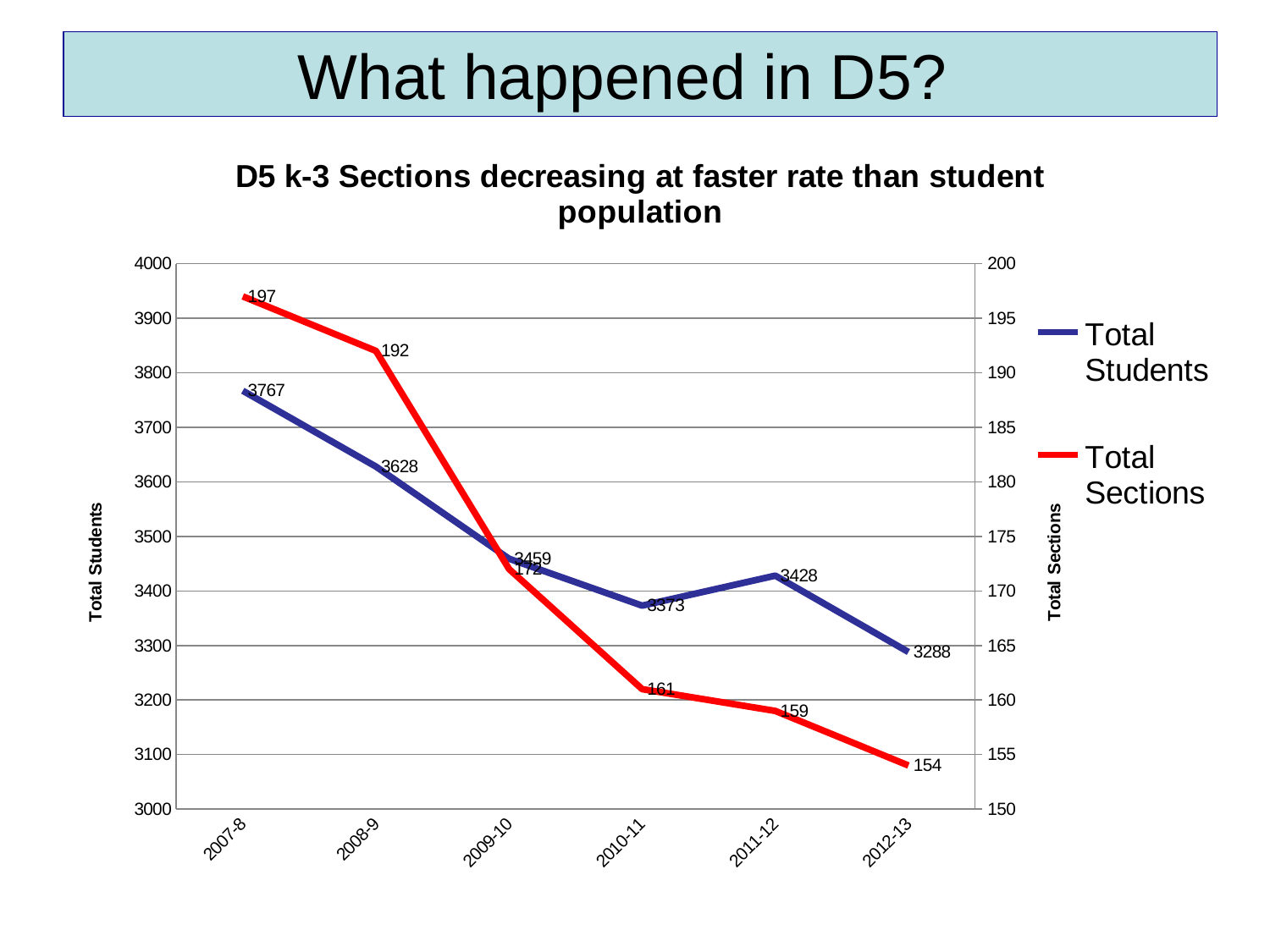
What kind of chart is shown on the slide? Line chart What is the value for Total Students in 2007-8? 3767 How many series does the legend list? 2 What is the value for Total Students in 2011-12? 3428 What is the value for Total Sections in 2012-13? 154 What is the difference between Total Students in 2007-8 and 2012-13? 479 In which year is Total Students lowest? 2012-13 How many years are shown on the x axis? 6 In which year is Total Sections highest? 2007-8 What is the difference between Total Sections in 2008-9 and 2009-10? 20 Which is larger, Total Students in 2010-11 or in 2011-12? 2011-12 What is the value for Total Sections in 2010-11? 161